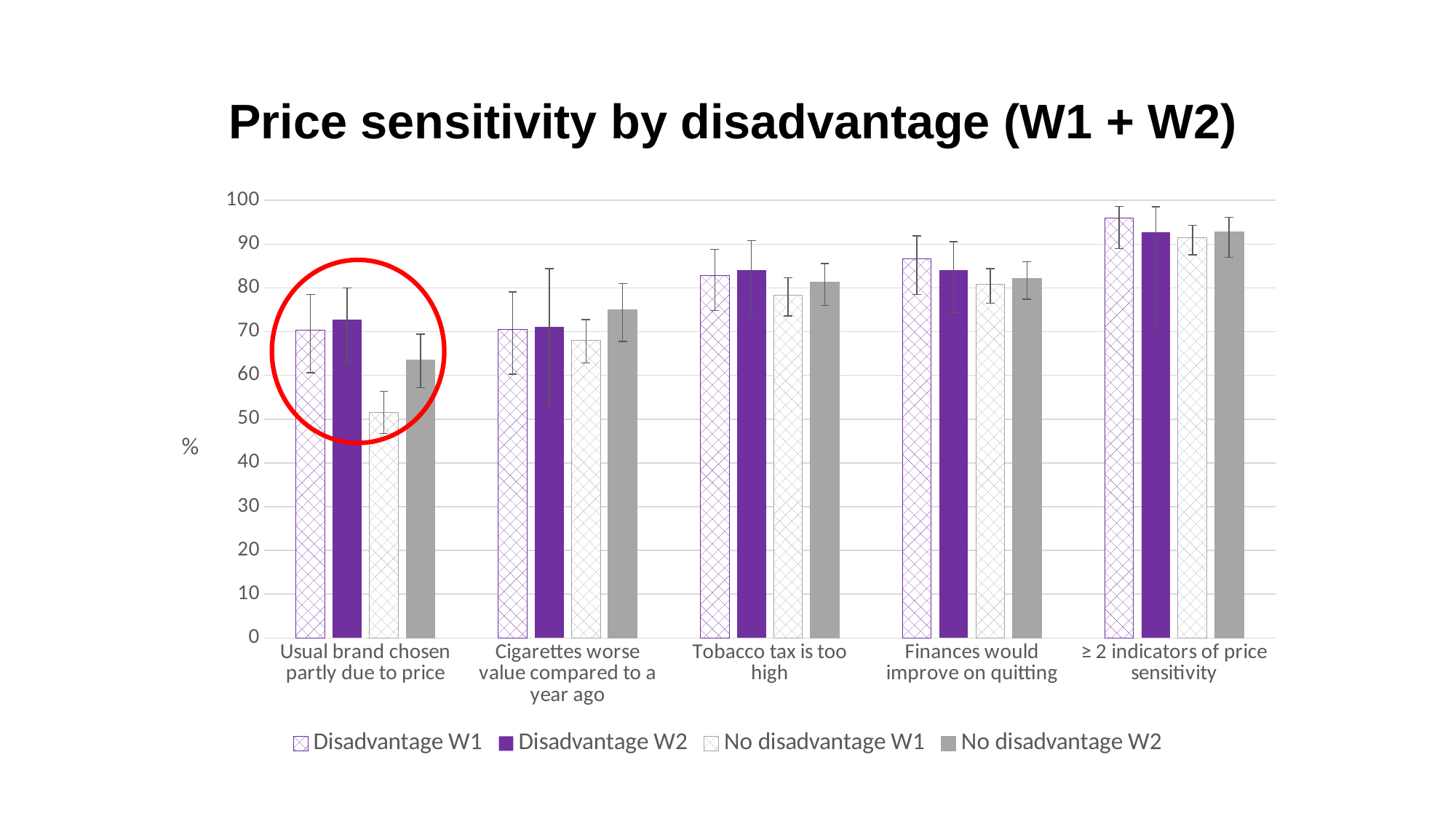
Is the value for No disadvantage W1 in the 'Usual brand chosen partly due to price' category greater or less than 60? less Which category is highlighted with a red circle on the chart? Usual brand chosen partly due to price Is the value for Disadvantage W1 in the 'Tobacco tax is too high' category greater or less than 80? greater Which category has the highest value for Disadvantage W1? ≥ 2 indicators of price sensitivity Is the value for Disadvantage W1 in the '≥ 2 indicators of price sensitivity' category greater or less than 90? greater Which category has the lowest value for No disadvantage W1? Usual brand chosen partly due to price In the 'Usual brand chosen partly due to price' category, which is larger: Disadvantage W2 or No disadvantage W1? Disadvantage W2 How many series does the legend list? 4 What kind of chart is shown on the slide? Bar chart How many categories are shown along the x axis? 5 In the 'Usual brand chosen partly due to price' category, which series has the lowest value? No disadvantage W1